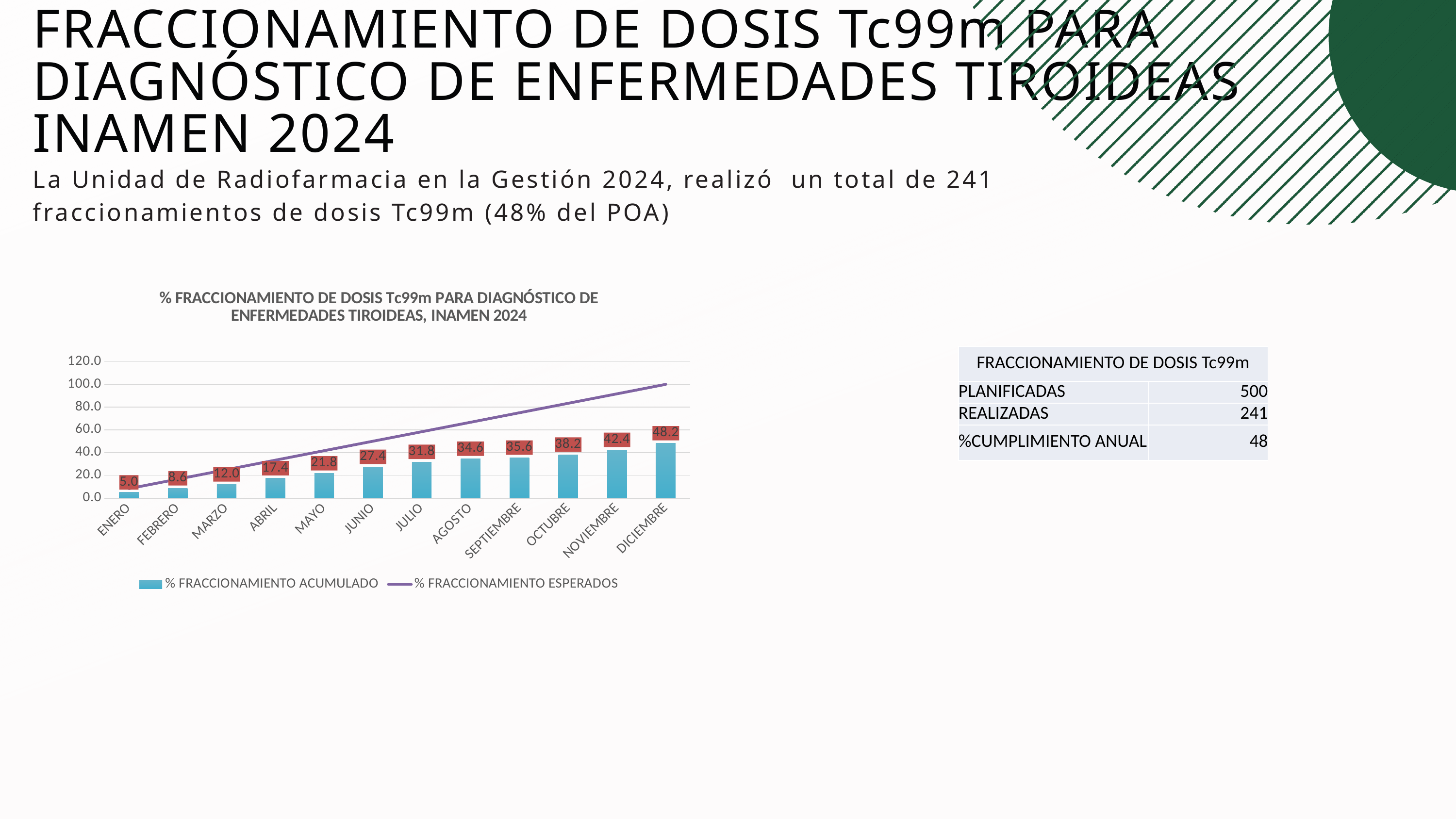
Which series in the chart is drawn as a line? % FRACCIONAMIENTO ESPERADOS Is the % FRACCIONAMIENTO ESPERADOS value for DICIEMBRE greater or less than 80.0? greater What is the difference between the % FRACCIONAMIENTO ACUMULADO values for DICIEMBRE and NOVIEMBRE? 5.8 How many months are shown on the x axis of the chart? 12 Which month has the highest % FRACCIONAMIENTO ACUMULADO value? DICIEMBRE Which month has the lowest % FRACCIONAMIENTO ACUMULADO value? ENERO Which has a larger % FRACCIONAMIENTO ACUMULADO value, MARZO or ABRIL? ABRIL How many series does the chart legend list? 2 What is the % FRACCIONAMIENTO ACUMULADO value for DICIEMBRE? 48.2 What is the % FRACCIONAMIENTO ACUMULADO value for ENERO? 5.0 Do the % FRACCIONAMIENTO ACUMULADO values rise or fall from ENERO to DICIEMBRE? rise What is the % FRACCIONAMIENTO ACUMULADO value for JUNIO? 27.4